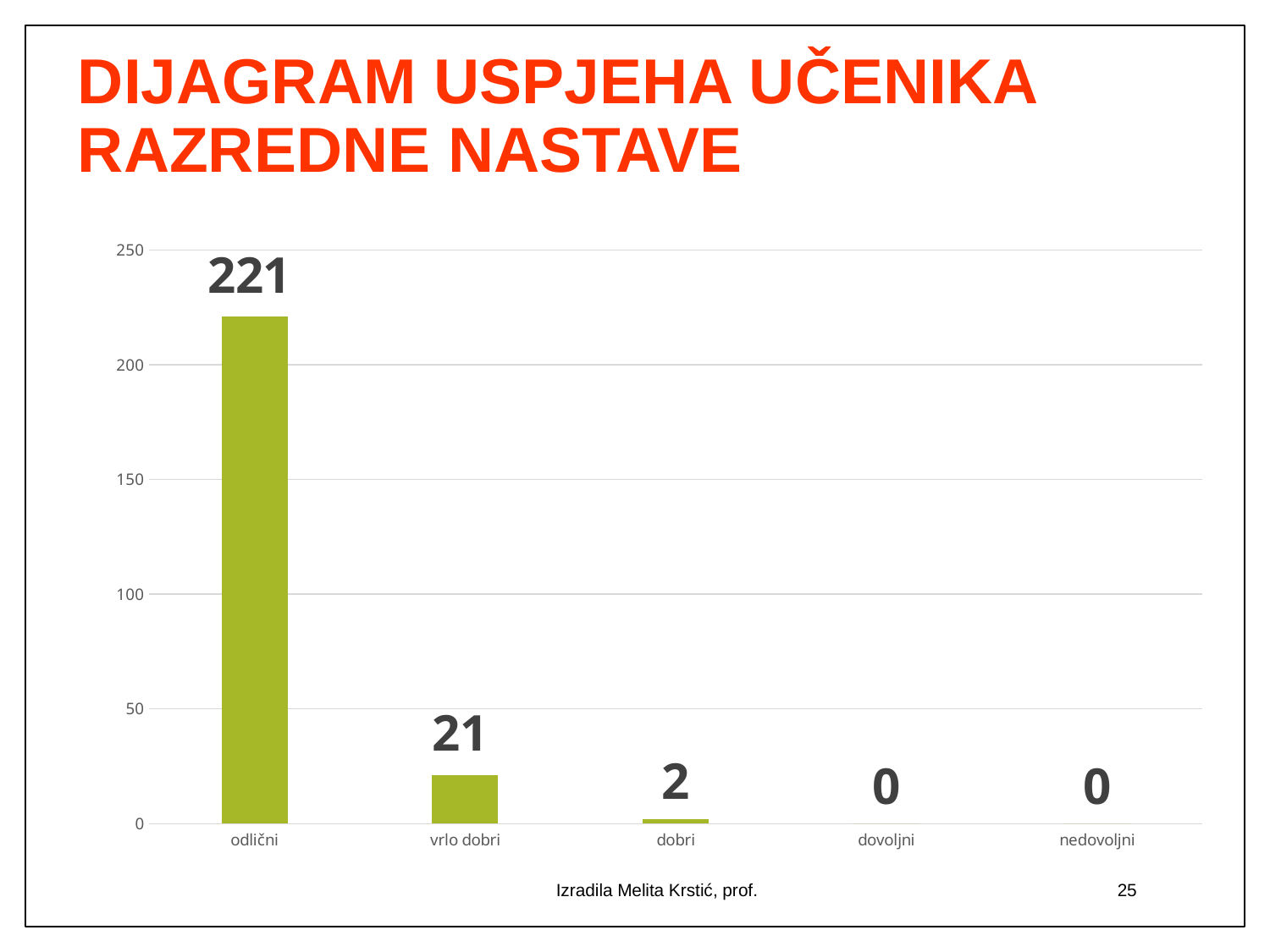
What is the difference between the values for vrlo dobri and dobri? 19 What is the value for dobri? 2 What is the difference between the values for odlični and vrlo dobri? 200 Do the values rise or fall from left to right along the x axis? fall Which is larger, the value for vrlo dobri or the value for dobri? vrlo dobri What is the value for dovoljni? 0 What kind of chart is shown on the slide? bar chart Which category has the highest value? odlični How many categories are shown on the x axis? 5 What is the value for odlični? 221 Is the value for odlični greater or less than 200? greater What is the value for vrlo dobri? 21